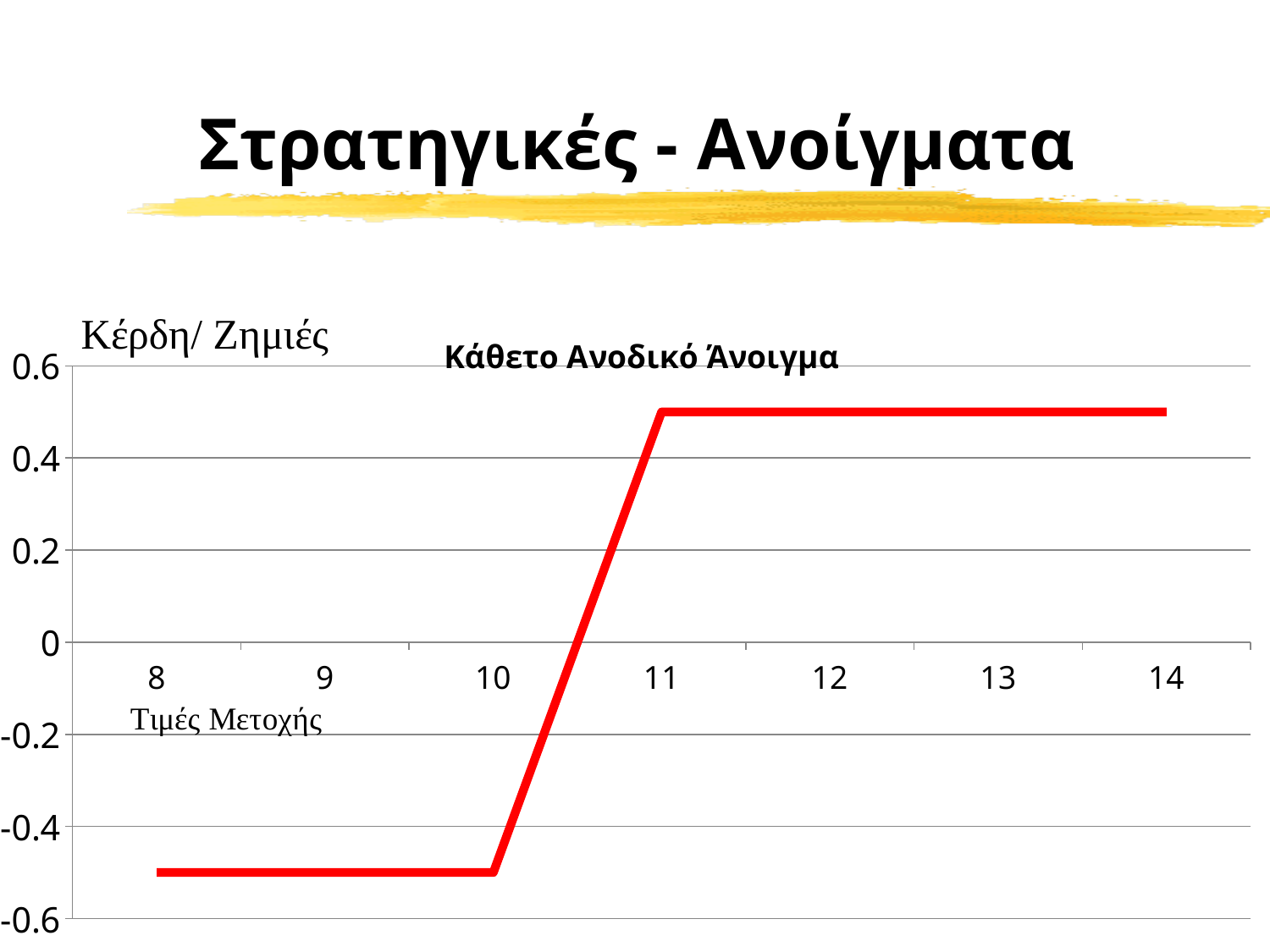
What is the title of the chart? Κάθετο Ανοδικό Άνοιγμα Is the value for stock price 10 greater or less than 0? less Does the line rise or fall between stock prices 10 and 11? rise Which is larger, the value at stock price 12 or the value at stock price 9? stock price 12 Is the value for stock price 13 greater or less than 0.4? greater How many stock price values are marked on the x axis? 7 Is the value for stock price 9 greater or less than 0? less What is the label of the x axis of the chart? Τιμές Μετοχής Is the value at stock price 14 higher or lower than the value at stock price 8? higher What kind of chart is shown on the slide? line chart